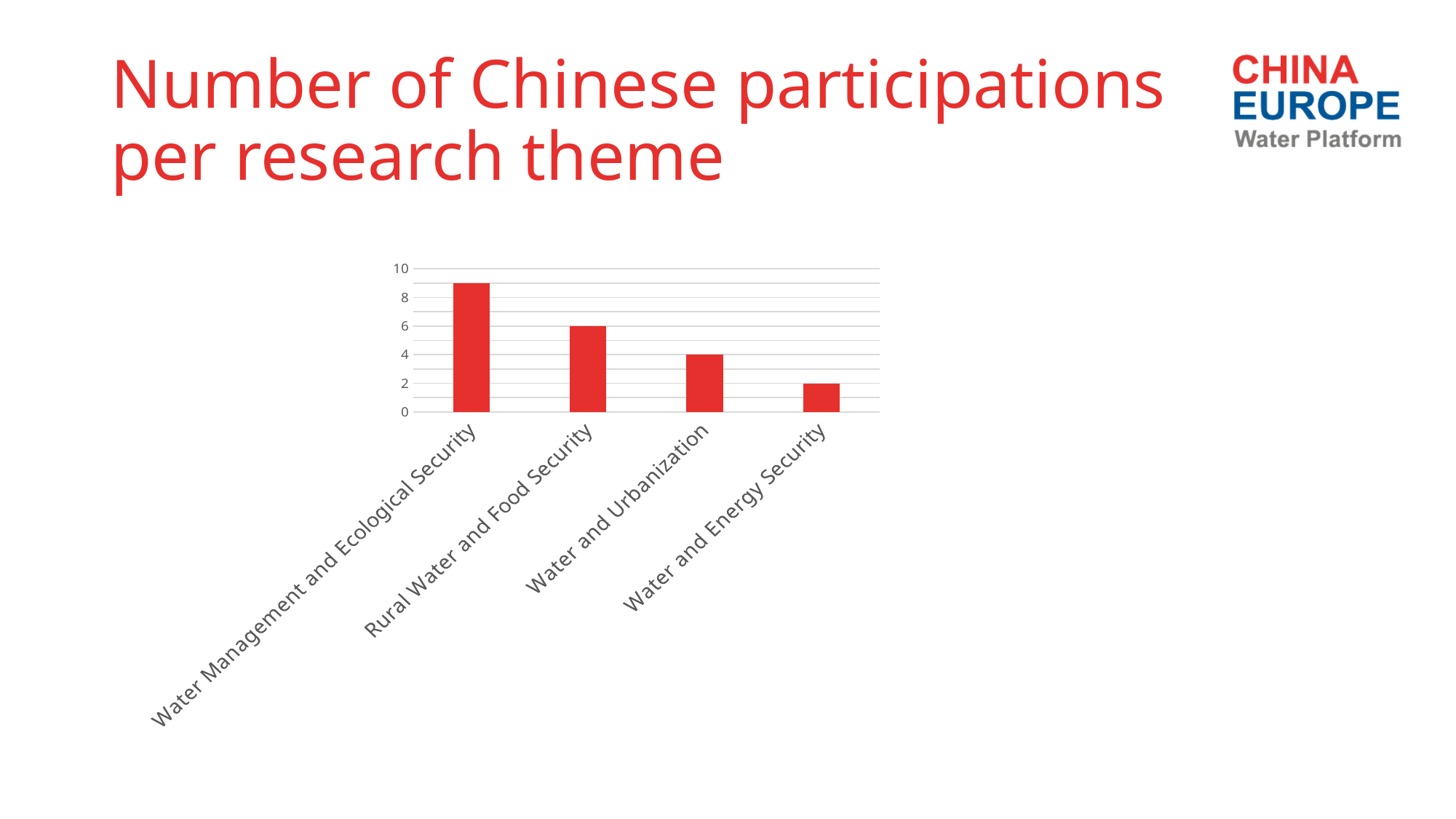
What is the value for Water and Energy Security? 2 Is the value for Water Management and Ecological Security greater or less than 8? greater What is the difference between the values for Water and Urbanization and Water and Energy Security? 2 Which is larger, the value for Rural Water and Food Security or the value for Water and Urbanization? Rural Water and Food Security What is the difference between the values for Rural Water and Food Security and Water and Energy Security? 4 Do the values rise or fall from left to right along the x axis? fall Which research theme has the highest number of Chinese participations? Water Management and Ecological Security How many research themes are shown on the chart? 4 Which research theme has the lowest number of Chinese participations? Water and Energy Security What is the value for Rural Water and Food Security? 6 What is the value for Water and Urbanization? 4 What kind of chart is shown on the slide? bar chart